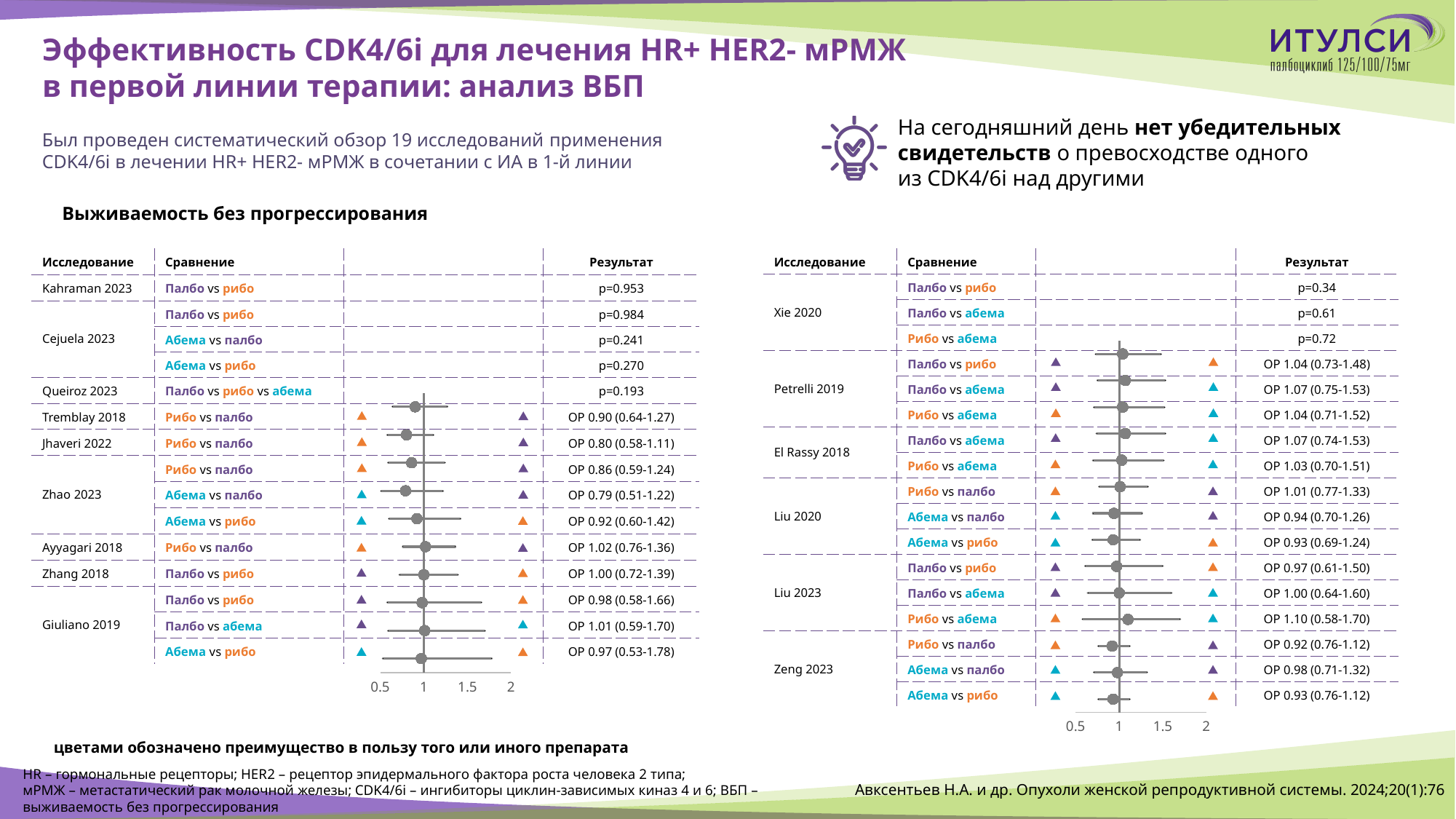
What tick values are shown on the x axis of the left chart? 0.5, 1, 1.5, 2 In the right chart, is the hazard ratio point estimate for Zeng 2023, Рибо vs палбо greater or less than 1? less In the left chart, what p-value is shown for Kahraman 2023 (Палбо vs рибо)? p=0.953 In the right chart, what is the result shown for Liu 2023, Рибо vs абема? ОР 1.10 (0.58-1.70) In the left chart, what is the result shown for Tremblay 2018 (Рибо vs палбо)? ОР 0.90 (0.64-1.27) In the left chart, which has the larger hazard ratio point estimate: Jhaveri 2022 (Рибо vs палбо) or Ayyagari 2018 (Рибо vs палбо)? Ayyagari 2018 In the left chart, which study and comparison has the lowest hazard ratio (ОР) point estimate? Zhao 2023, Абема vs палбо (ОР 0.79) In the right chart, which study and comparison has the highest hazard ratio (ОР) point estimate? Liu 2023, Рибо vs абема (ОР 1.10) What kind of chart is used on this slide to display the hazard ratios? Forest plot How many studies are listed in the right chart's table? 6 In the left chart, what is the difference between the hazard ratio point estimates for Giuliano 2019 Палбо vs абема and Giuliano 2019 Палбо vs рибо? 0.03 In the right chart, what p-value is shown for Xie 2020, Палбо vs рибо? p=0.34